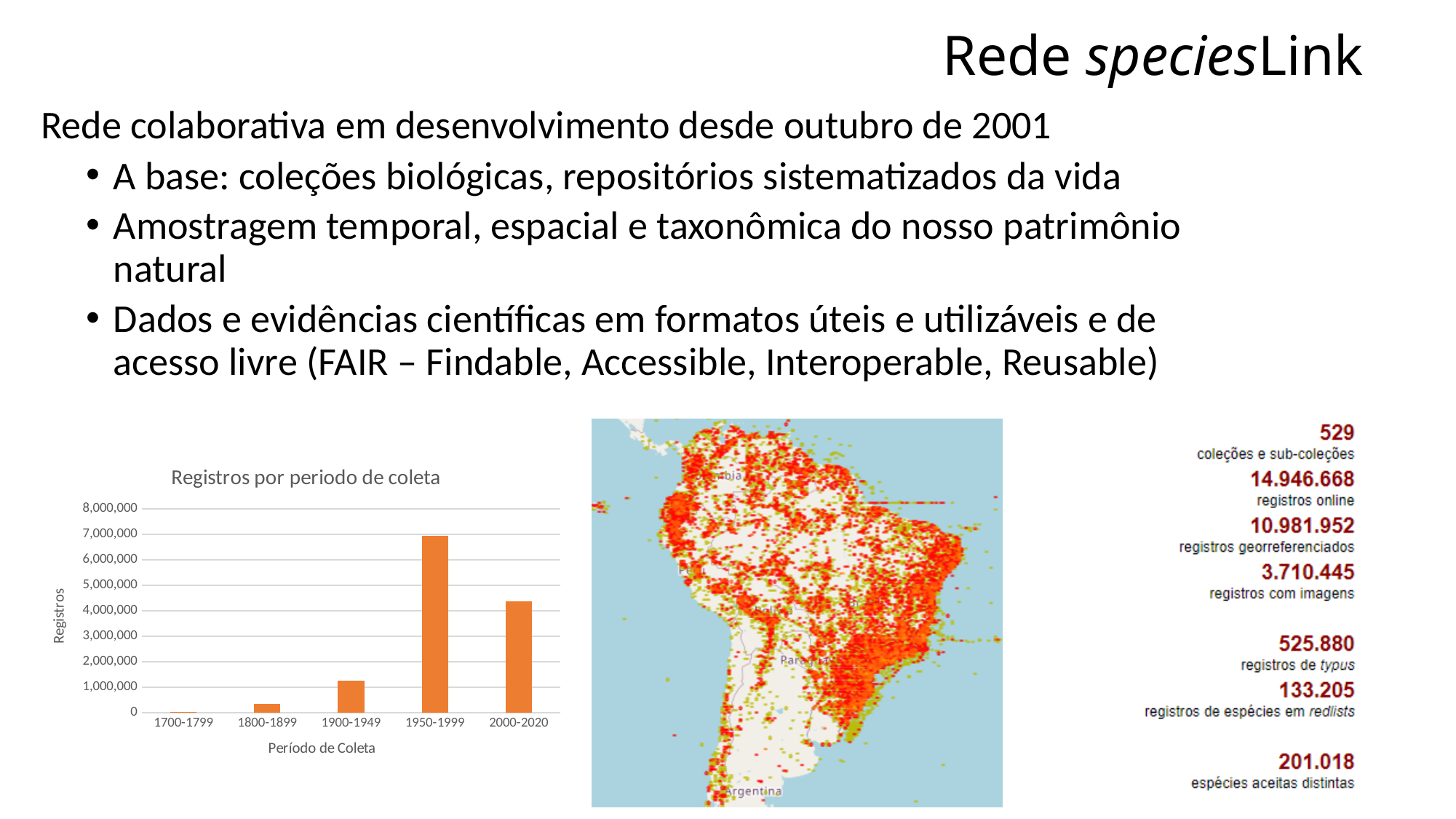
What is the label of the x axis of the chart? Período de Coleta What type of chart is "Registros por periodo de coleta"? bar chart Which period has more registros, 1800-1899 or 1900-1949? 1900-1949 Is the value for 1950-1999 greater or less than 6,000,000? greater Is the value for 1900-1949 greater or less than 1,000,000? greater Which period has more registros, 1950-1999 or 2000-2020? 1950-1999 Which collection period has the highest number of registros? 1950-1999 What is the title of the chart on the slide? Registros por periodo de coleta Is the value for 2000-2020 greater or less than 5,000,000? less Which collection period has the lowest number of registros? 1700-1799 How many collection periods are shown on the x axis of the chart? 5